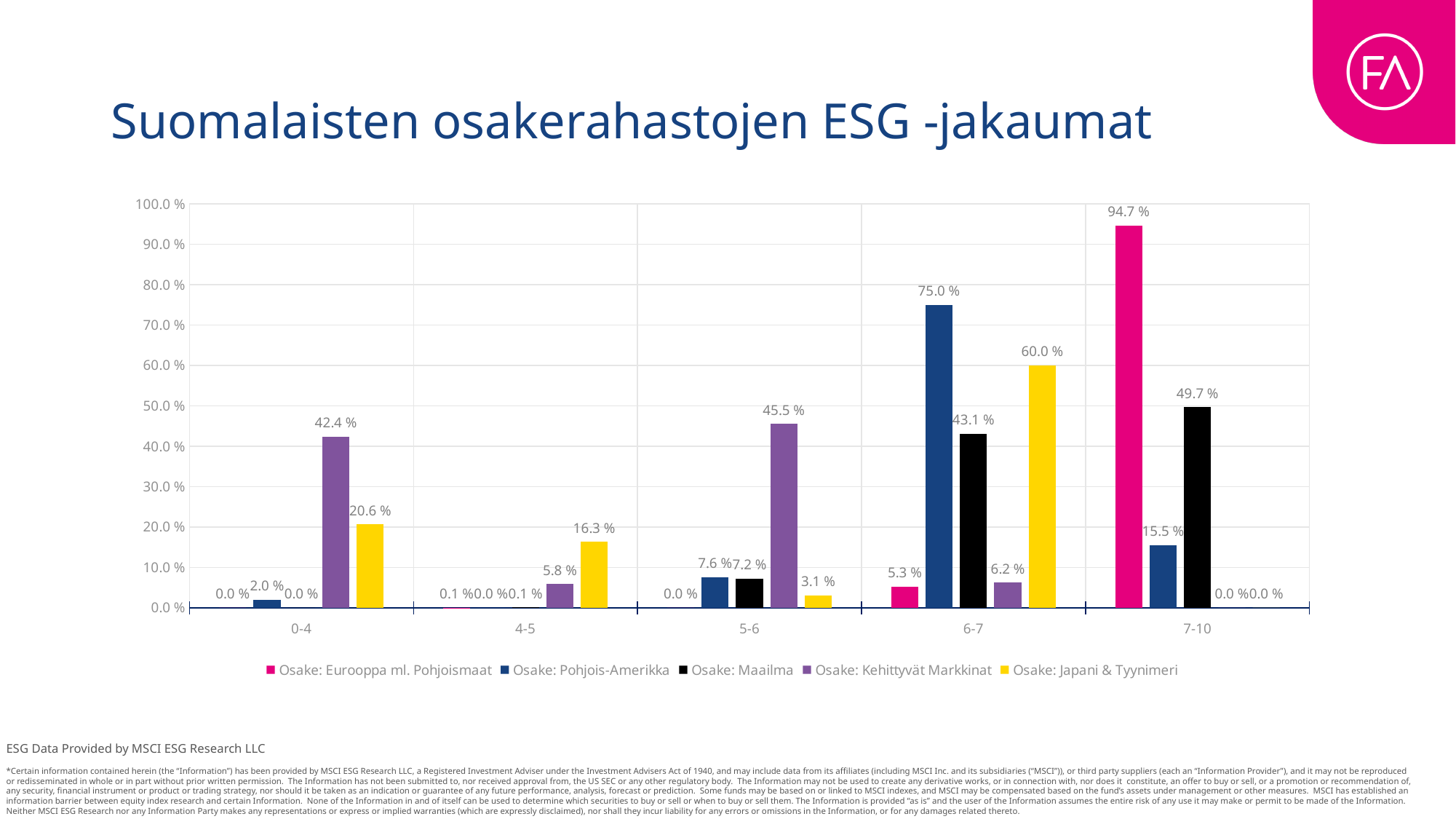
In which category does Osake: Maailma have its highest value? 7-10 What is the value for Osake: Pohjois-Amerikka in the 6-7 category? 75.0 % What is the value for Osake: Eurooppa ml. Pohjoismaat in the 7-10 category? 94.7 % Which series has the lowest value in the 5-6 category? Osake: Eurooppa ml. Pohjoismaat How many ESG score categories are shown on the x axis? 5 What is the title of the chart? Suomalaisten osakerahastojen ESG -jakaumat What is the difference between Osake: Pohjois-Amerikka and Osake: Japani & Tyynimeri in the 6-7 category? 15.0 % What is the value for Osake: Japani & Tyynimeri in the 4-5 category? 16.3 % What kind of chart is shown on the slide? bar chart In the 7-10 category, which is larger: Osake: Maailma or Osake: Pohjois-Amerikka? Osake: Maailma How many series does the legend list? 5 What is the value for Osake: Kehittyvät Markkinat in the 0-4 category? 42.4 %